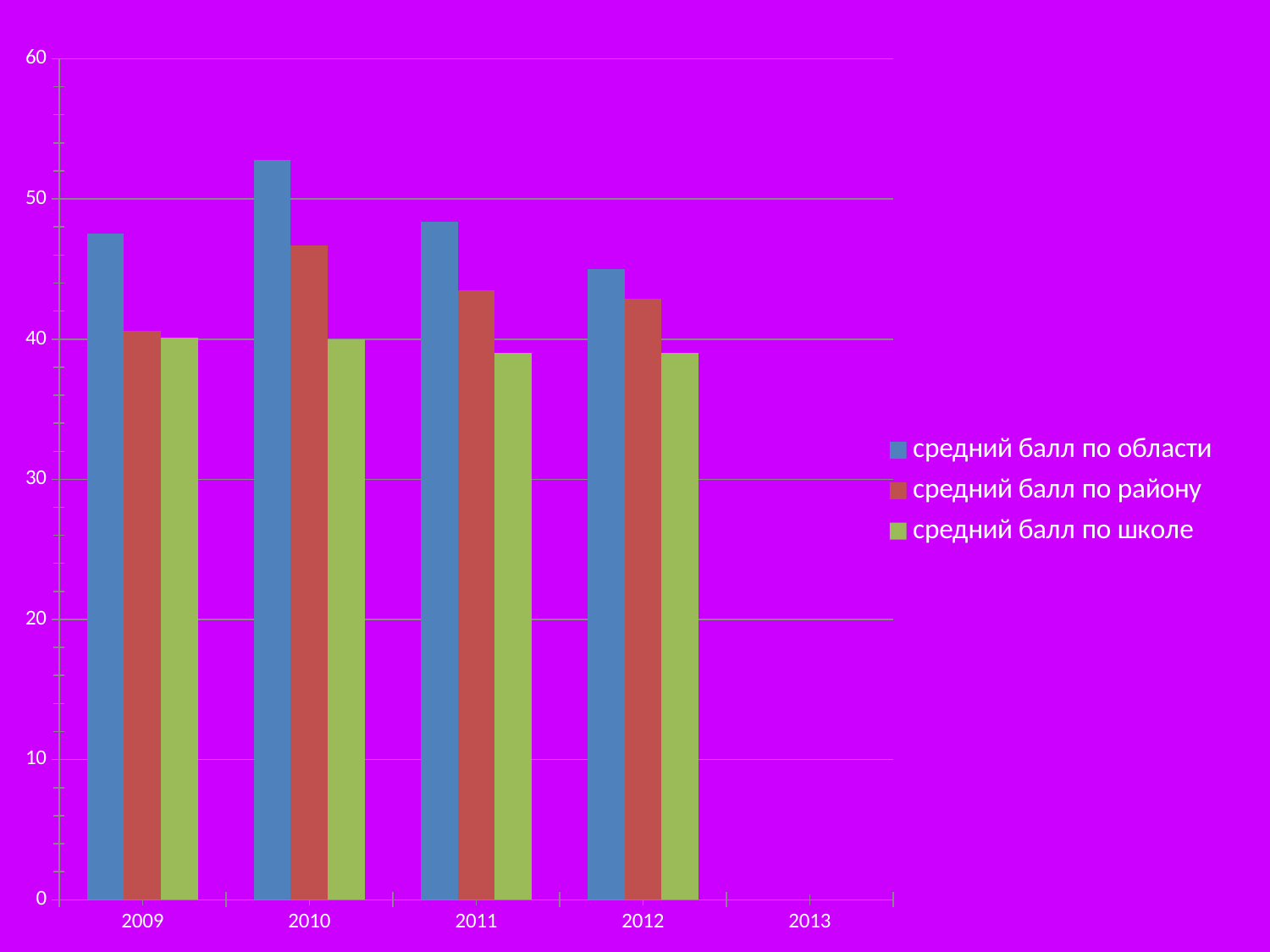
Is the value for 'средний балл по области' in 2010 greater or less than 50? greater Which series has the lowest value in 2010? средний балл по школе For how many years are bars actually plotted? 4 How many series does the legend list? 3 How many year categories are labelled on the x axis? 5 Is the value for 'средний балл по району' in 2011 greater or less than 40? greater What kind of chart is shown on the slide? bar chart Do the values for 'средний балл по области' rise or fall from 2010 to 2012? fall In 2009, which is larger: 'средний балл по области' or 'средний балл по району'? средний балл по области In which year is the value for 'средний балл по области' highest? 2010 Is the value for 'средний балл по школе' in 2012 greater or less than 40? less In which year is the value for 'средний балл по области' lowest? 2012